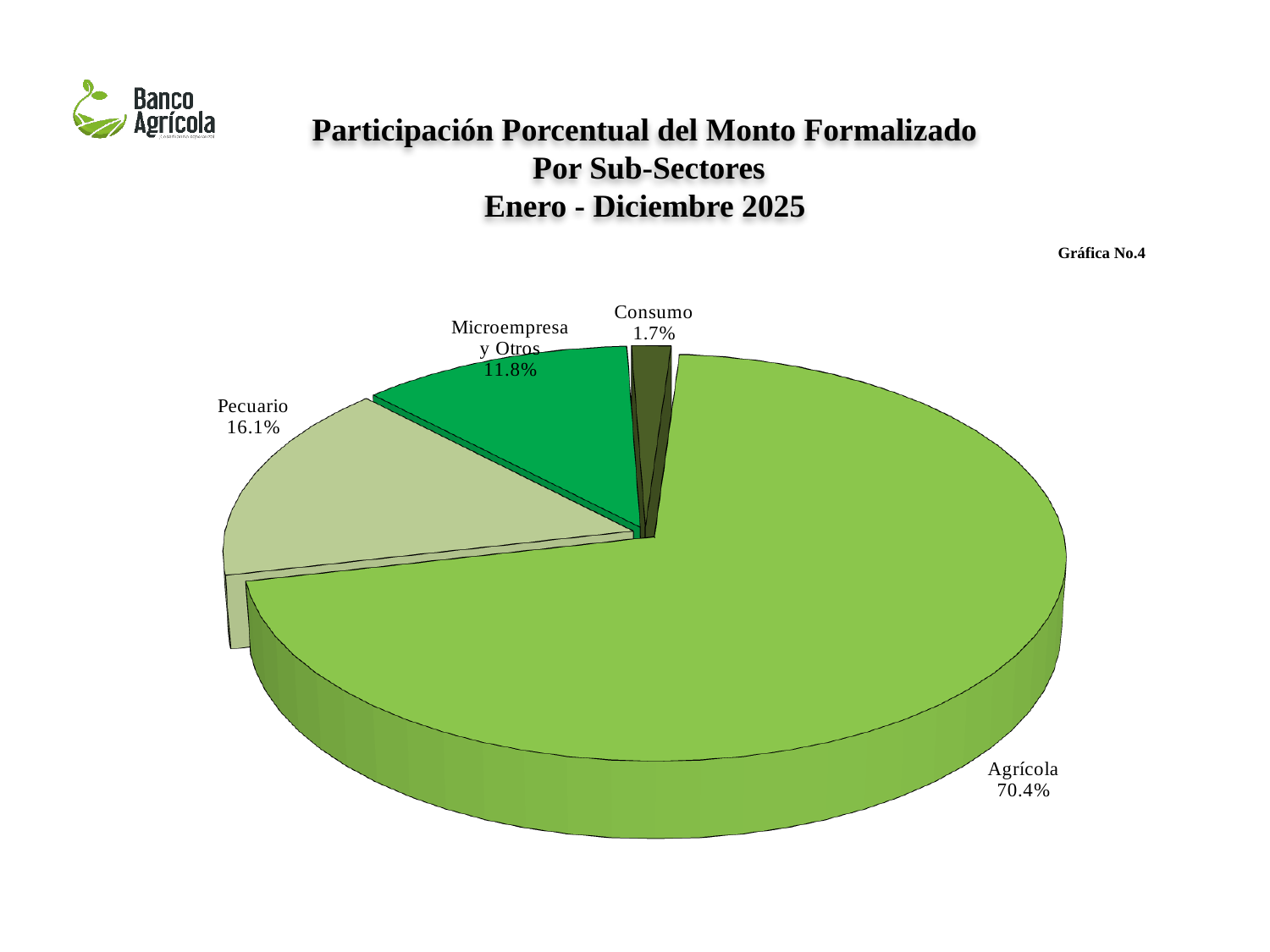
What is the share for Agrícola? 70.4% What period does the chart title cover? Enero - Diciembre 2025 Which sub-sector has the smallest share? Consumo Which is larger, the share for Pecuario or the share for Microempresa y Otros? Pecuario What type of chart is shown on the slide? Pie chart How many slices does the pie chart have? 4 Which sub-sector has the largest share? Agrícola What is the combined share of Pecuario and Consumo? 17.8% What is the share for Pecuario? 16.1% What is the difference in percentage points between Pecuario and Microempresa y Otros? 4.3 What is the share for Microempresa y Otros? 11.8% What is the share for Consumo? 1.7%